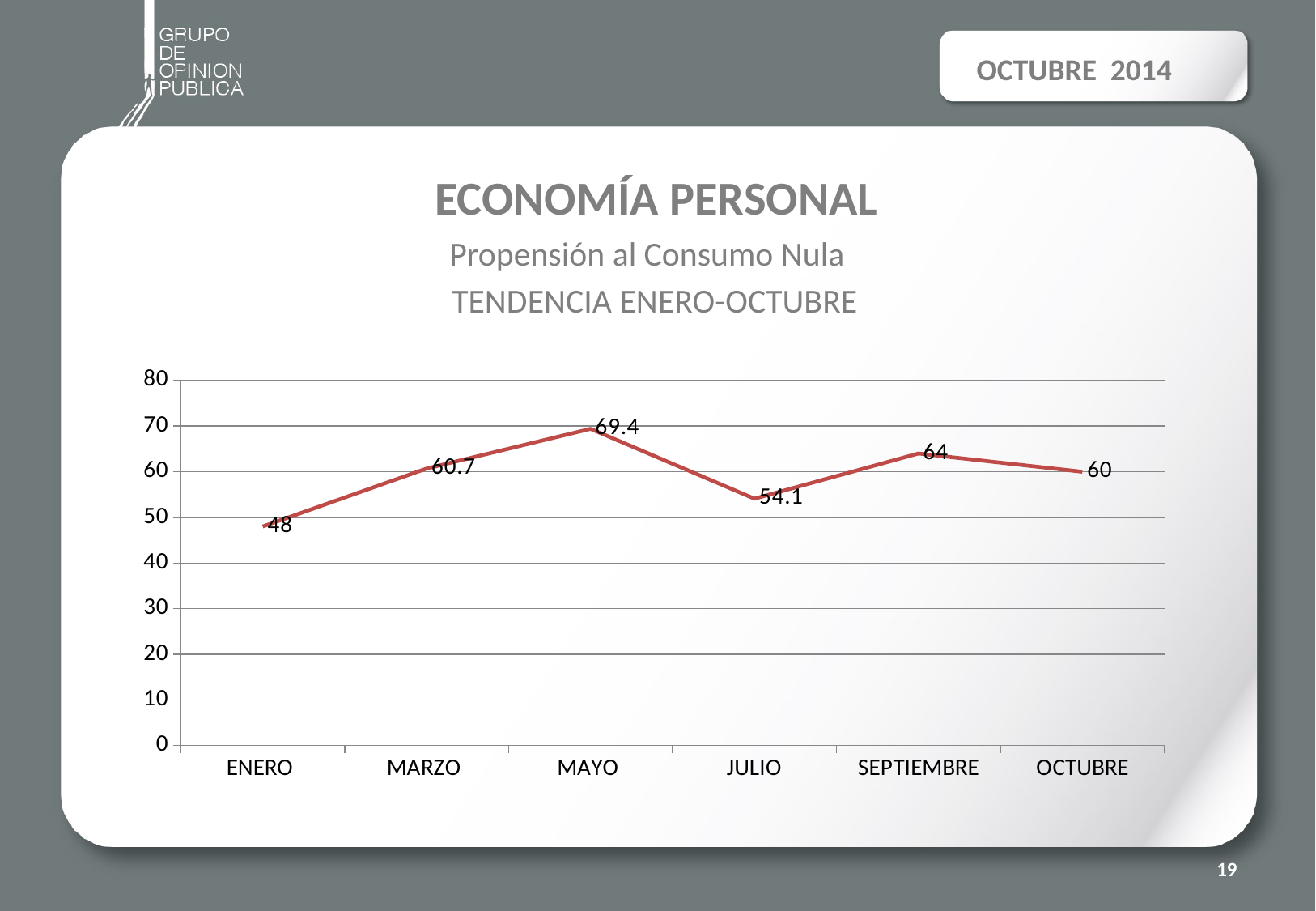
Which month has the lowest value? ENERO Which month has the highest value? MAYO Which is larger, the value for MARZO or the value for JULIO? MARZO Does the value rise or fall from SEPTIEMBRE to OCTUBRE? fall How many months are plotted on the x axis? 6 What is the difference between the values for MAYO and ENERO? 21.4 What is the value for MAYO? 69.4 What is the value for OCTUBRE? 60 What kind of chart is shown? line chart What is the difference between the values for SEPTIEMBRE and JULIO? 9.9 What is the value for ENERO? 48 What is the value for JULIO? 54.1